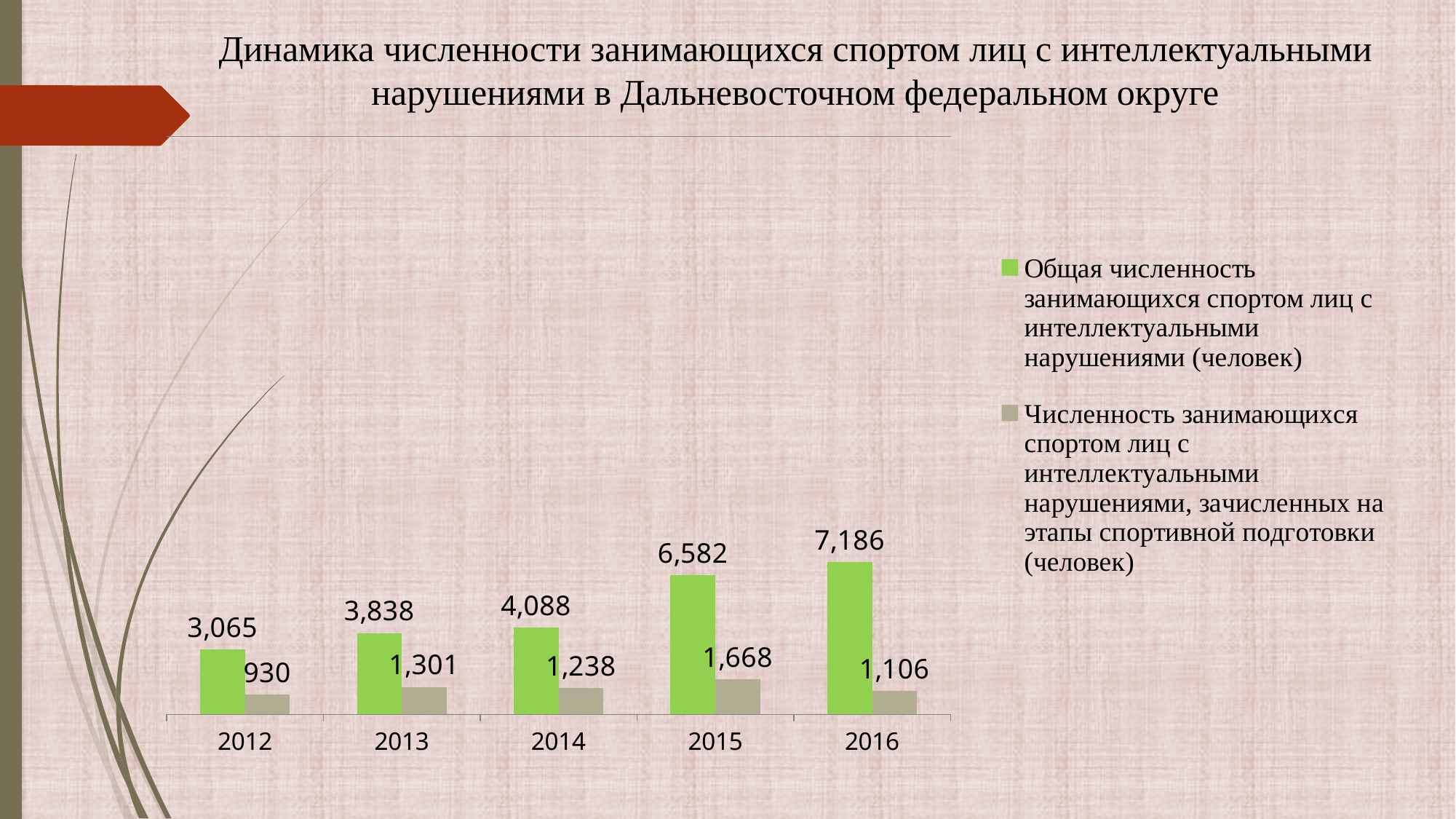
By how much did the total number engaged in sport (green series) increase from 2014 to 2015? 2,494 What is the difference between the green and grey values in 2016? 6,080 What colour represents the series 'Общая численность занимающихся спортом лиц с интеллектуальными нарушениями (человек)'? Green Which year has the larger grey-series value: 2014 or 2015? 2015 What kind of chart is shown on the slide? Bar chart Does the green series (total number engaged in sport) rise or fall from 2012 to 2016? Rises What is the value of the grey series (enrolled in sports training stages) for 2013? 1,301 How many series does the legend list? 2 In which year is the number enrolled in sports training stages (grey series) the lowest? 2012 In which year is the total number of people engaged in sport (green series) the highest? 2016 How many years are shown on the x axis? 5 What is the total number of people with intellectual disabilities engaged in sport (green series) in 2015? 6,582